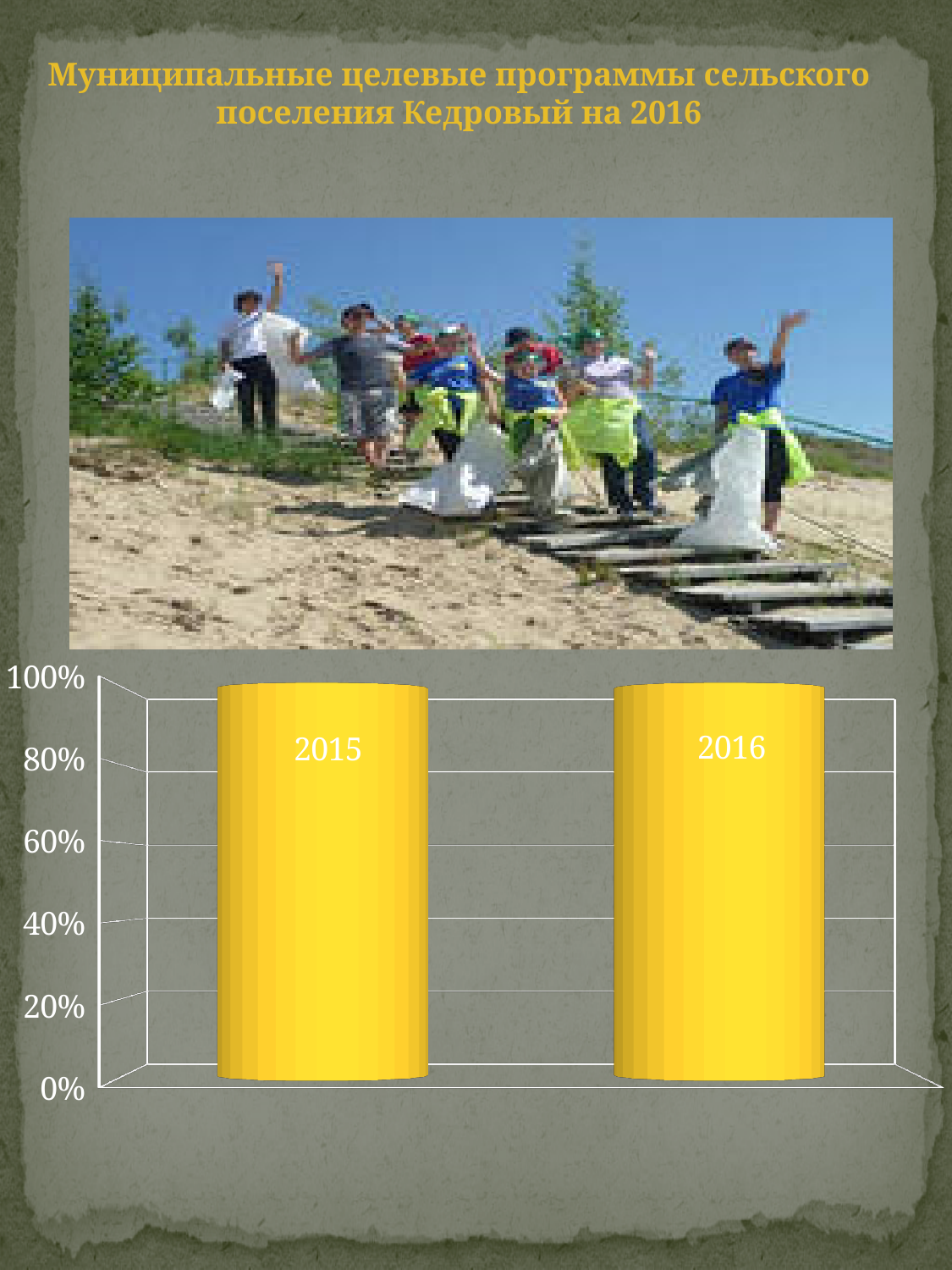
What is the highest value shown on the vertical axis? 100% Is the value for 2015 greater or less than 80%? greater How many bars does the chart show? 2 What are the labels printed on the two bars? 2015 and 2016 Is the value for 2016 greater or less than 80%? greater What colour are the bars in the chart? yellow Is the value for 2016 greater or less than 40%? greater What kind of chart is shown on the slide? bar chart